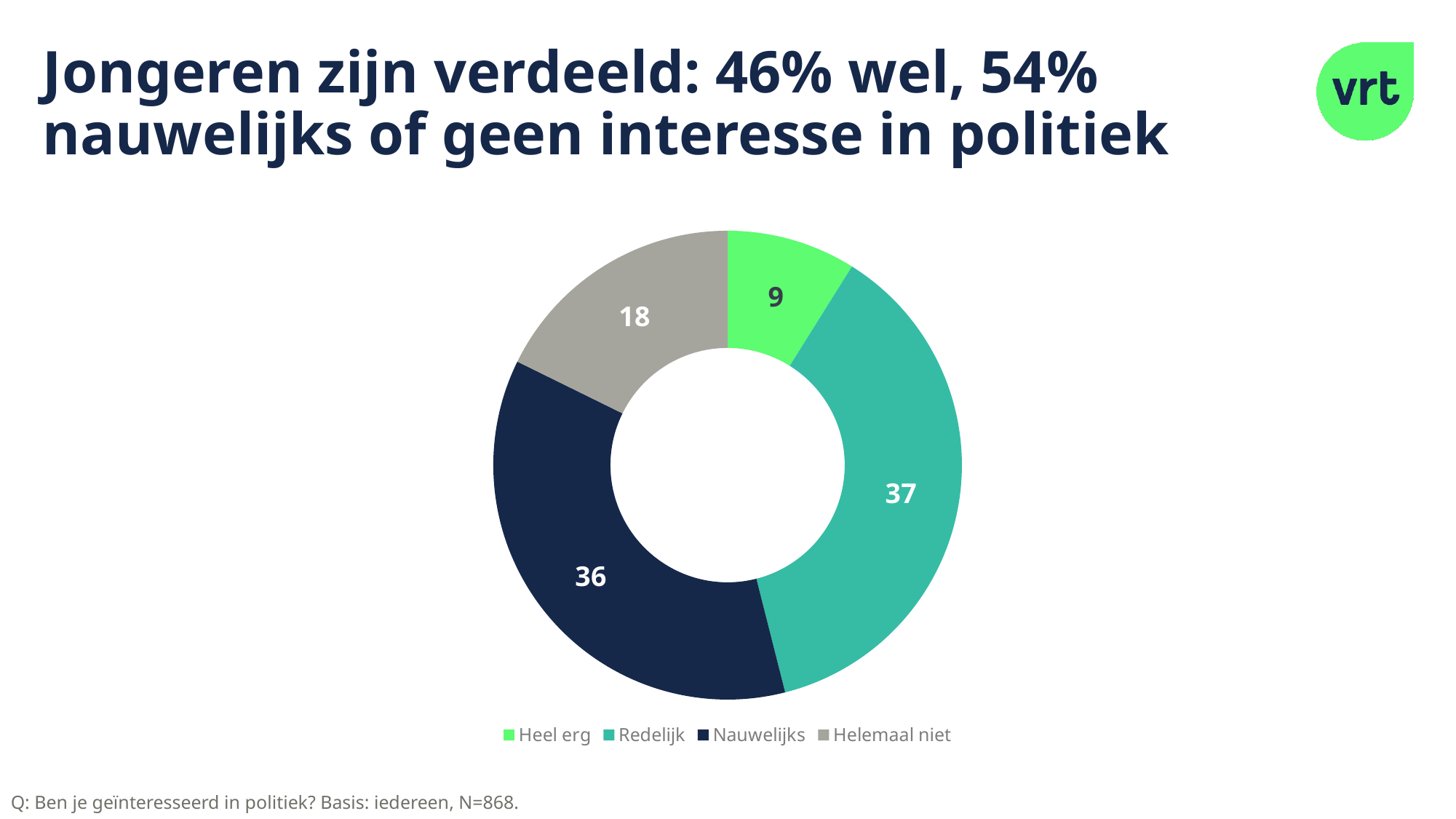
What kind of chart is shown on the slide? doughnut chart What value is shown for the Helemaal niet slice? 18 Which colour represents the Nauwelijks category in the legend? dark navy blue Which category has the smallest slice? Heel erg Which is larger, the Helemaal niet slice or the Heel erg slice? Helemaal niet What value is shown for the Redelijk slice? 37 Which category has the largest slice? Redelijk What value is shown for the Nauwelijks slice? 36 What is the difference between the Nauwelijks and Helemaal niet values? 18 How many categories does the chart show? 4 What value is shown for the Heel erg slice? 9 What is the difference between the Redelijk and Heel erg values? 28